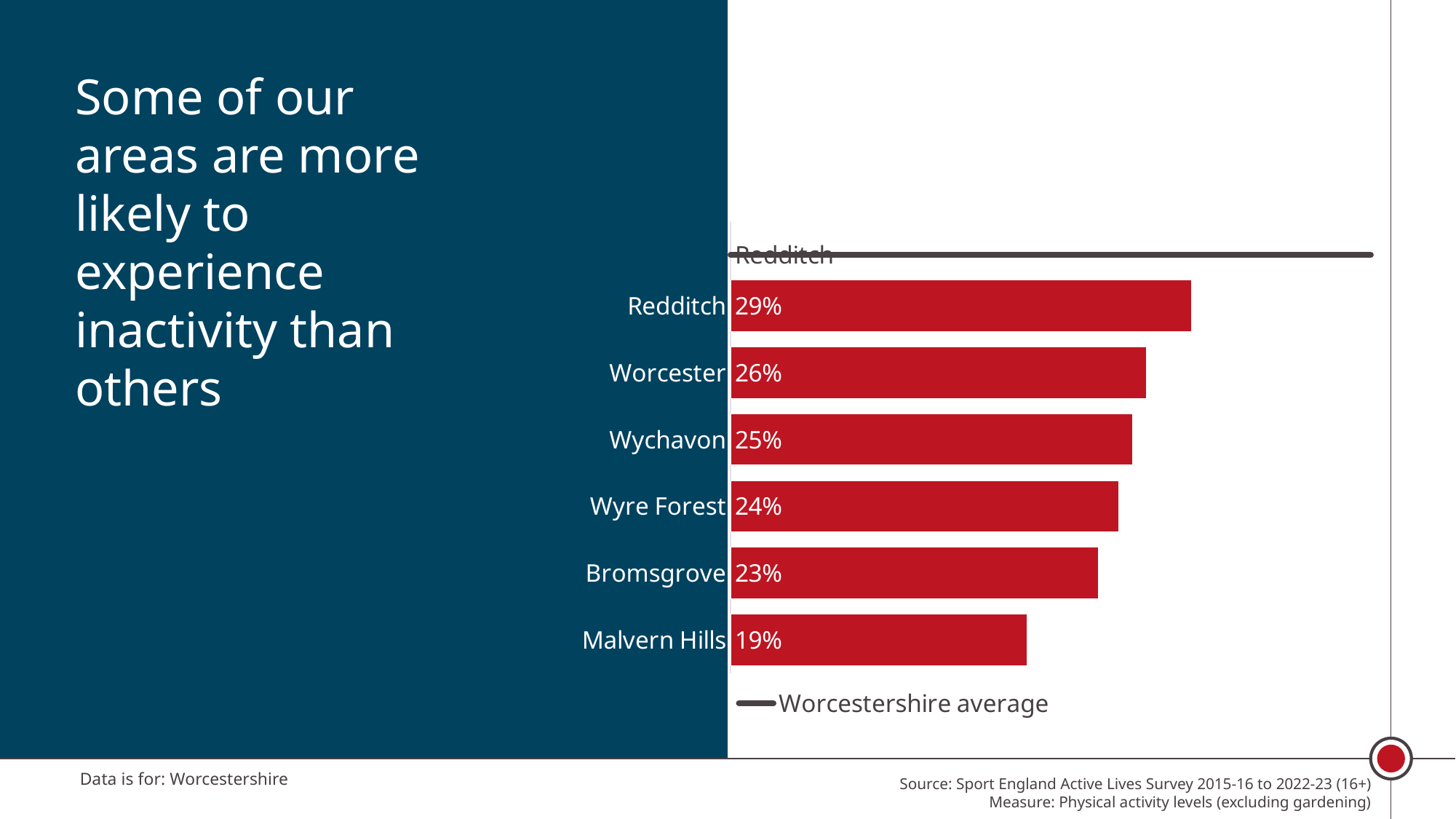
Which has a larger value, Wychavon or Bromsgrove? Wychavon What kind of chart is shown on the slide? Bar chart What is the value for Wychavon? 25% How many areas are shown in the chart? 6 What is the legend entry shown below the bars? Worcestershire average What is the value for Redditch? 29% What is the value for Bromsgrove? 23% What is the difference between the values for Redditch and Malvern Hills? 10% Which area has the highest value? Redditch What is the value for Malvern Hills? 19% What is the difference between the values for Worcester and Wyre Forest? 2% Which area has the lowest value? Malvern Hills